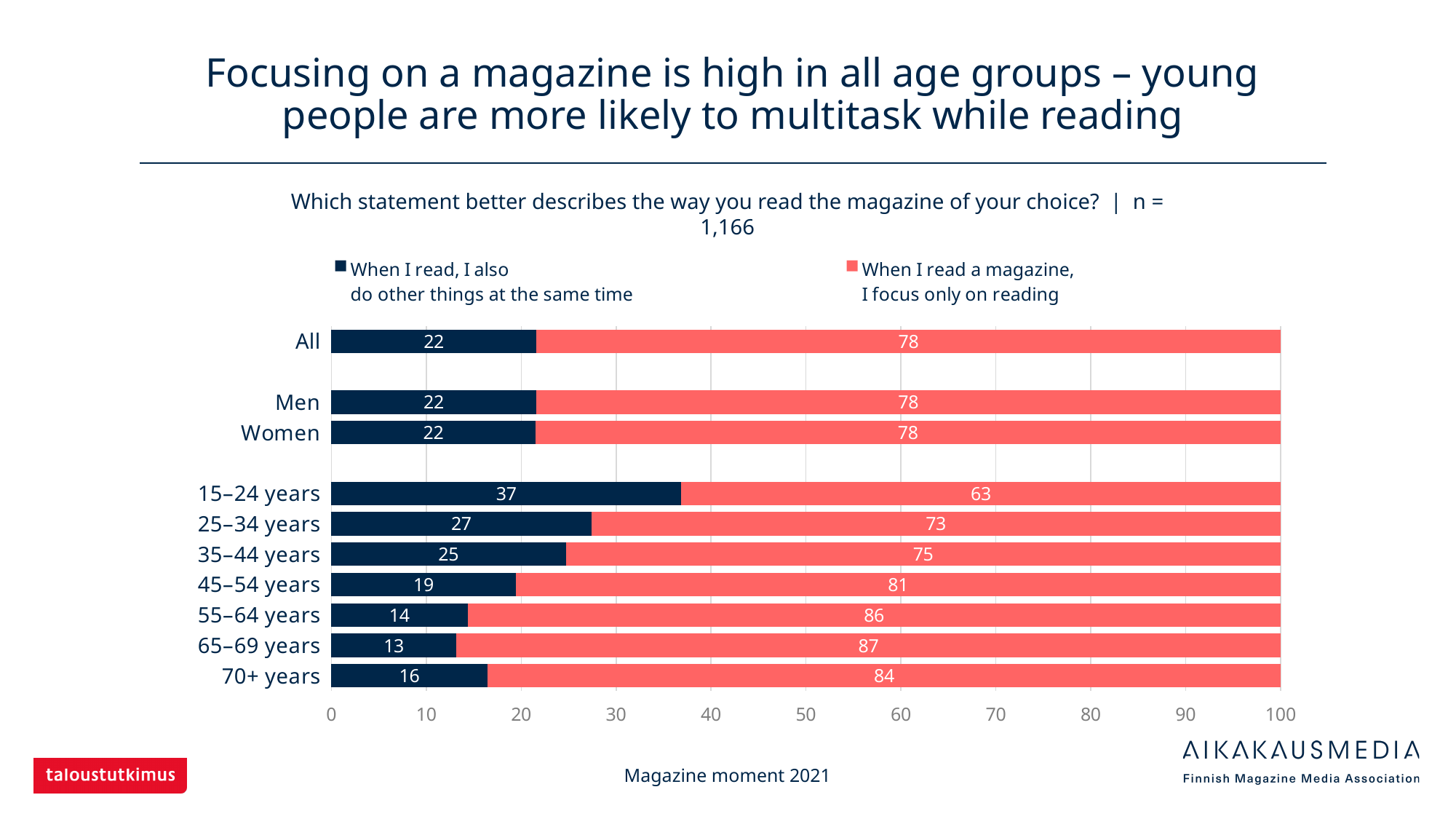
Which age group has the highest value for 'When I read, I also do other things at the same time'? 15–24 years Which age group has the lowest value for 'When I read, I also do other things at the same time'? 65–69 years How many categories are shown on the vertical axis of the chart? 10 What is the value for 'When I read a magazine, I focus only on reading' among 55–64 year olds? 86 What is the value for 'When I read, I also do other things at the same time' for Women? 22 What percentage of 15–24 year olds say they also do other things at the same time when they read? 37 Is the 'focus only on reading' value for 45–54 years greater or less than 80? greater What kind of chart is shown on the slide? Stacked bar chart What is the difference between the 'focus only on reading' values for 65–69 years and 15–24 years? 24 What is the total of the stacked bar for 35–44 years? 100 Which is larger: the 'do other things at the same time' value for 25–34 years or for 70+ years? 25–34 years How many series does the legend list? 2